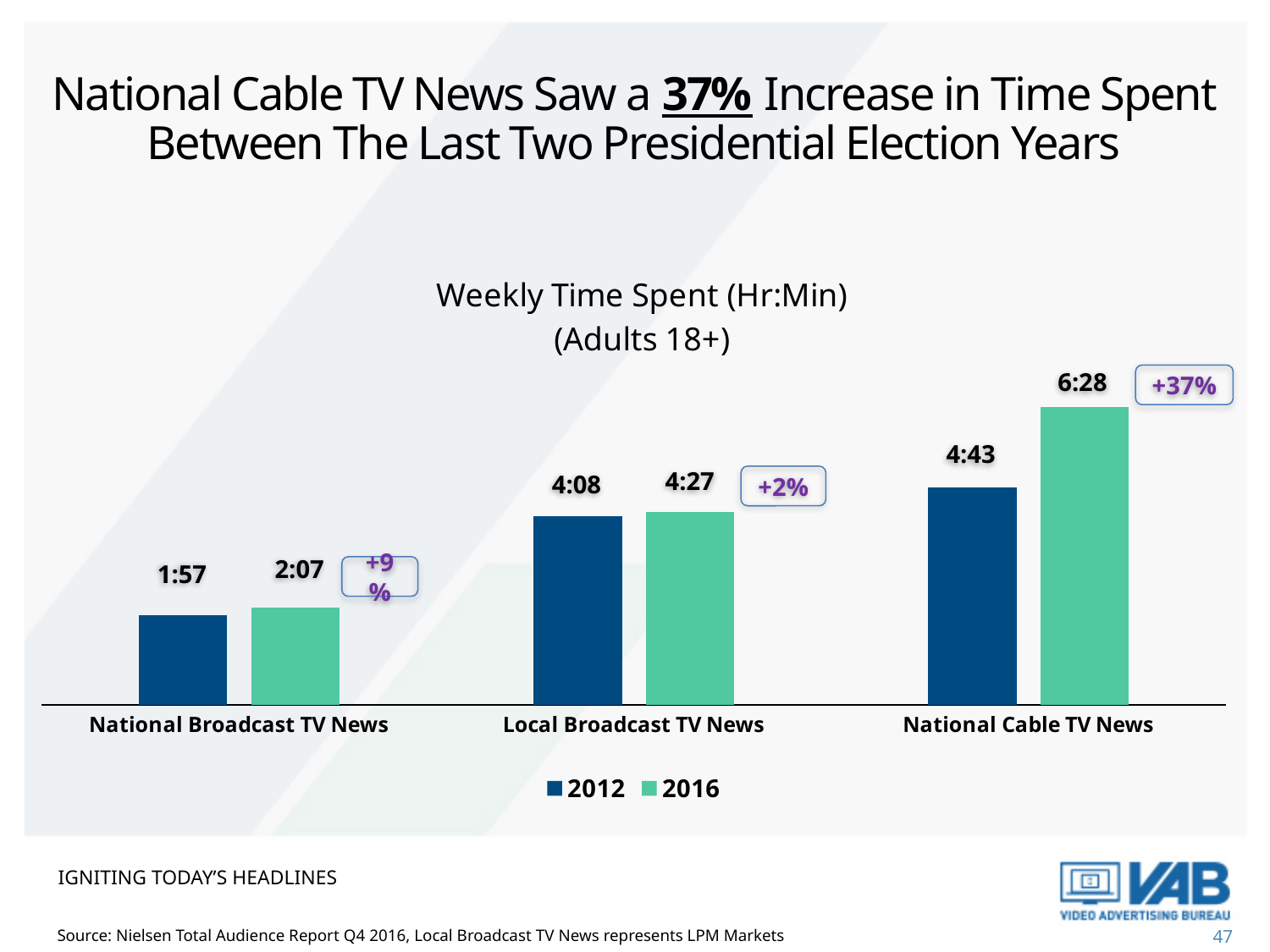
What was the weekly time spent on National Cable TV News in 2012? 4:43 What was the weekly time spent on National Broadcast TV News in 2012? 1:57 Which was larger: Local Broadcast TV News in 2012 or National Broadcast TV News in 2016? Local Broadcast TV News in 2012 What percentage change is shown for Local Broadcast TV News between 2012 and 2016? +2% What percentage change is shown for National Cable TV News between 2012 and 2016? +37% How many categories are shown on the x axis of the chart? 3 What was the weekly time spent on Local Broadcast TV News in 2016? 4:27 Which category had the lowest weekly time spent in 2012? National Broadcast TV News How many series does the legend list? 2 Which category had the highest weekly time spent in 2016? National Cable TV News What type of chart is shown on the slide? Bar chart What was the weekly time spent on National Cable TV News in 2016? 6:28